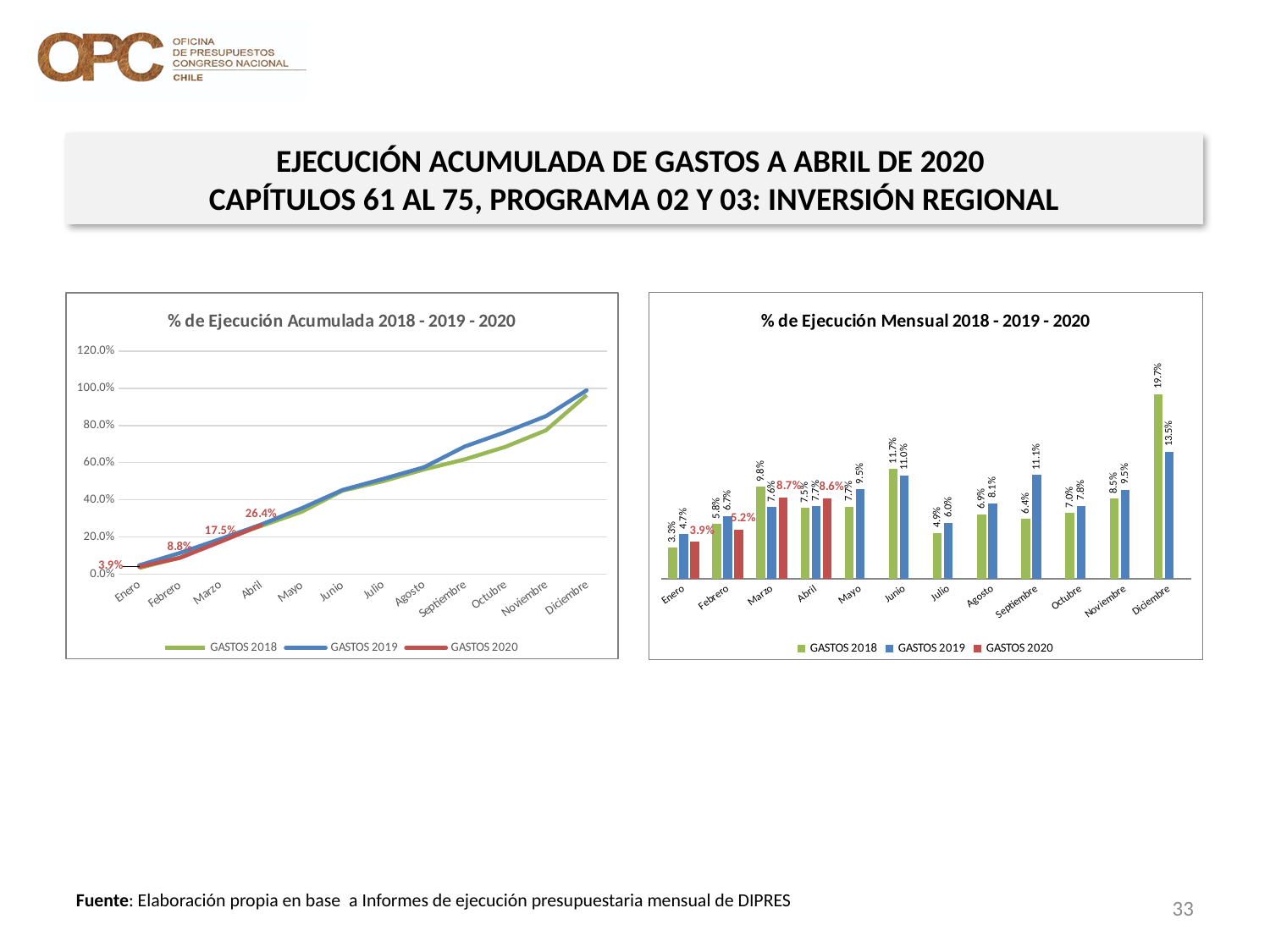
In the '% de Ejecución Mensual 2018 - 2019 - 2020' chart, what is the value for GASTOS 2018 in Diciembre? 19.7% In the '% de Ejecución Acumulada 2018 - 2019 - 2020' chart, how many series does the legend list? 3 In the '% de Ejecución Mensual 2018 - 2019 - 2020' chart, what is the value for GASTOS 2020 in Abril? 8.6% In the '% de Ejecución Acumulada 2018 - 2019 - 2020' chart, what kind of chart is shown? Line chart In the '% de Ejecución Acumulada 2018 - 2019 - 2020' chart, is the value for GASTOS 2019 in Noviembre greater or less than 80.0%? greater In the '% de Ejecución Mensual 2018 - 2019 - 2020' chart, what is the difference between GASTOS 2018 and GASTOS 2019 in Diciembre? 6.2% In the '% de Ejecución Mensual 2018 - 2019 - 2020' chart, which is larger in Septiembre: GASTOS 2018 or GASTOS 2019? GASTOS 2019 In the '% de Ejecución Acumulada 2018 - 2019 - 2020' chart, do the GASTOS 2019 values rise or fall from Enero to Diciembre? Rise In the '% de Ejecución Mensual 2018 - 2019 - 2020' chart, which month has the lowest value for GASTOS 2018? Enero In the '% de Ejecución Acumulada 2018 - 2019 - 2020' chart, what is the value for GASTOS 2020 in Abril? 26.4% In the '% de Ejecución Mensual 2018 - 2019 - 2020' chart, which month has the highest value for GASTOS 2019? Diciembre In the '% de Ejecución Acumulada 2018 - 2019 - 2020' chart, what is the value for GASTOS 2020 in Marzo? 17.5%